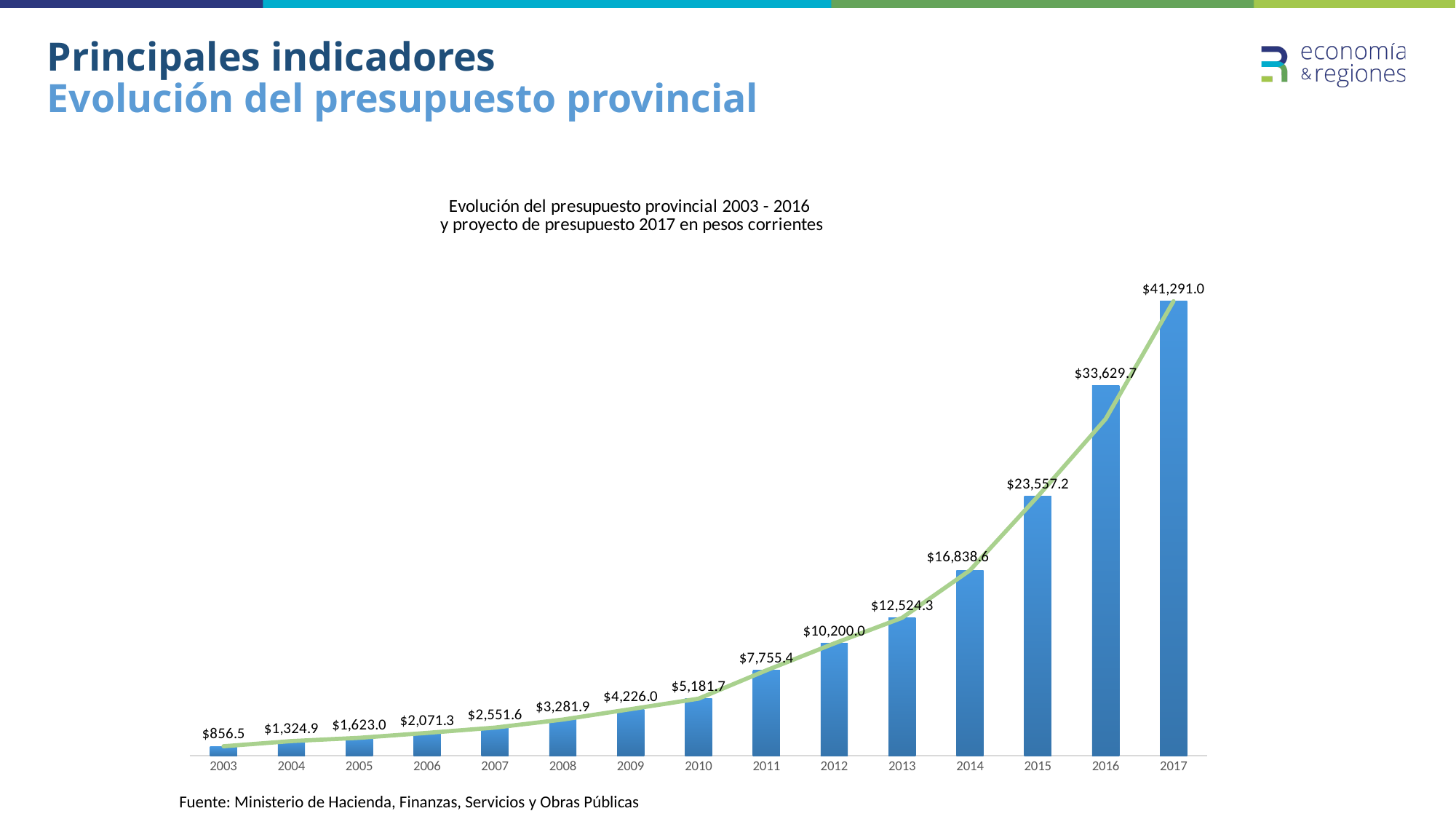
Which year has the lowest value? 2003 How many years are shown on the x axis? 15 What is the difference between the values for 2017 and 2016? $7,661.3 Which year has the highest value? 2017 Which is larger, the value for 2013 or the value for 2011? 2013 What is the value for 2003? $856.5 What is the value for 2009? $4,226.0 Do the values rise or fall from 2003 to 2017? Rise What is the value for 2017? $41,291.0 What is the value for 2012? $10,200.0 What kind of chart is this? Bar chart with a line overlay What is the difference between the values for 2016 and 2015? $10,072.5